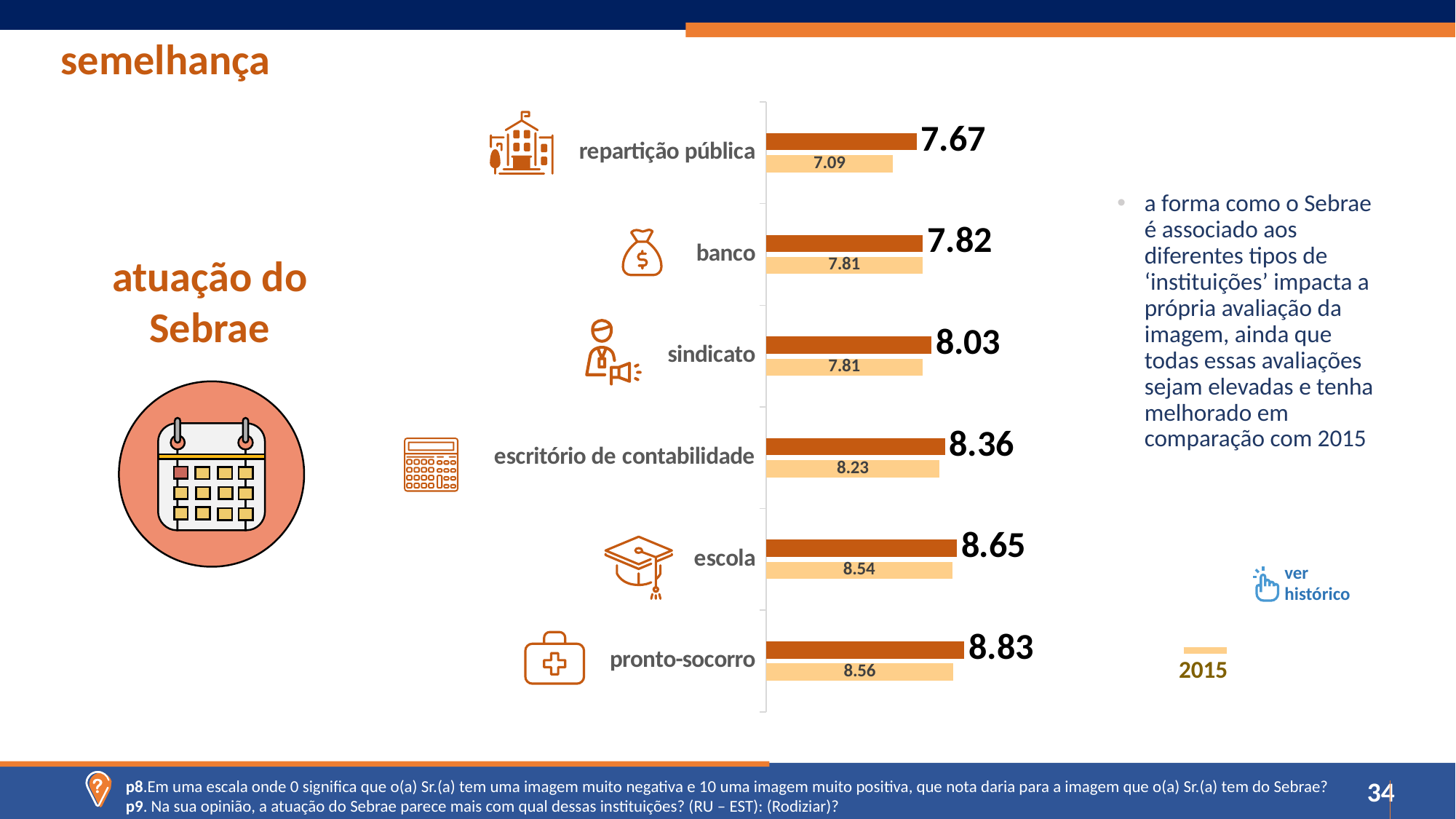
What is the difference between the large label value and the 2015 value for sindicato? 0.22 Which category has the highest value among the large (dark orange bar) labels? pronto-socorro How many categories (institutions) are shown in the chart? 6 Which category has the lowest 2015 value? repartição pública What is the value shown by the large label for sindicato? 8.03 What is the 2015 value for escritório de contabilidade? 8.23 Which is larger: the 2015 value for escola or the 2015 value for pronto-socorro? pronto-socorro What is the difference between the large label value and the 2015 value for repartição pública? 0.58 What is the 2015 value for repartição pública? 7.09 What is the value shown by the large label for pronto-socorro? 8.83 Which year is shown in the chart legend for the light orange bars? 2015 What type of chart is shown on the slide? bar chart